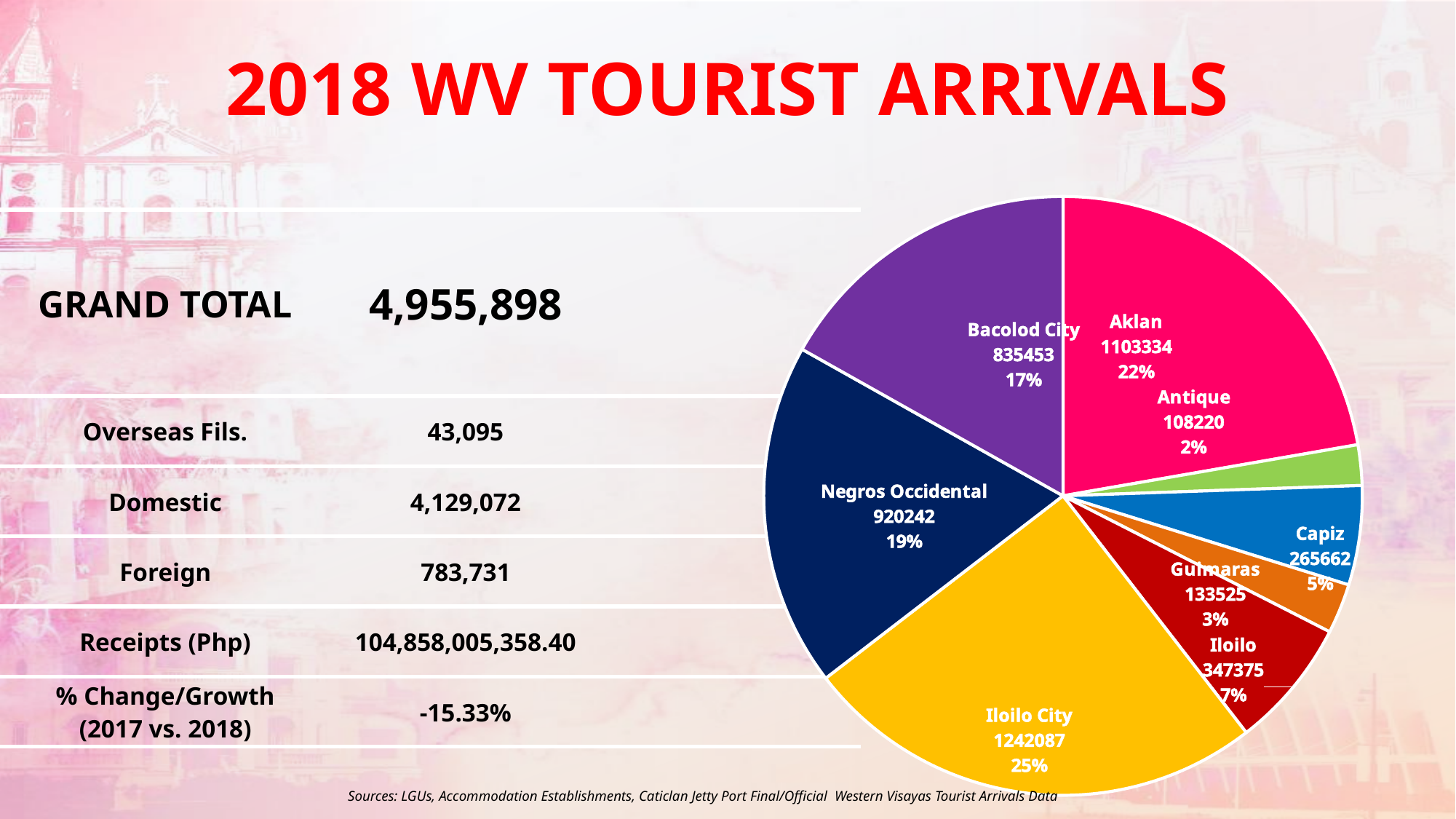
Which has a larger value, Guimaras or Iloilo? Iloilo What percentage share of the pie does Negros Occidental have? 19% Which slice of the pie chart is the smallest? Antique What kind of chart is shown on the slide? pie chart What is the difference between the values for Aklan and Bacolod City? 267881 What value is shown for Capiz in the pie chart? 265662 What percentage share does Bacolod City have in the pie chart? 17% Which slice of the pie chart is the largest? Iloilo City How many labelled slices does the pie chart have? 8 What is the value shown for Guimaras in the pie chart? 133525 How many tourist arrivals does the pie chart show for Iloilo City? 1242087 What is the title of the slide containing the pie chart? 2018 WV TOURIST ARRIVALS